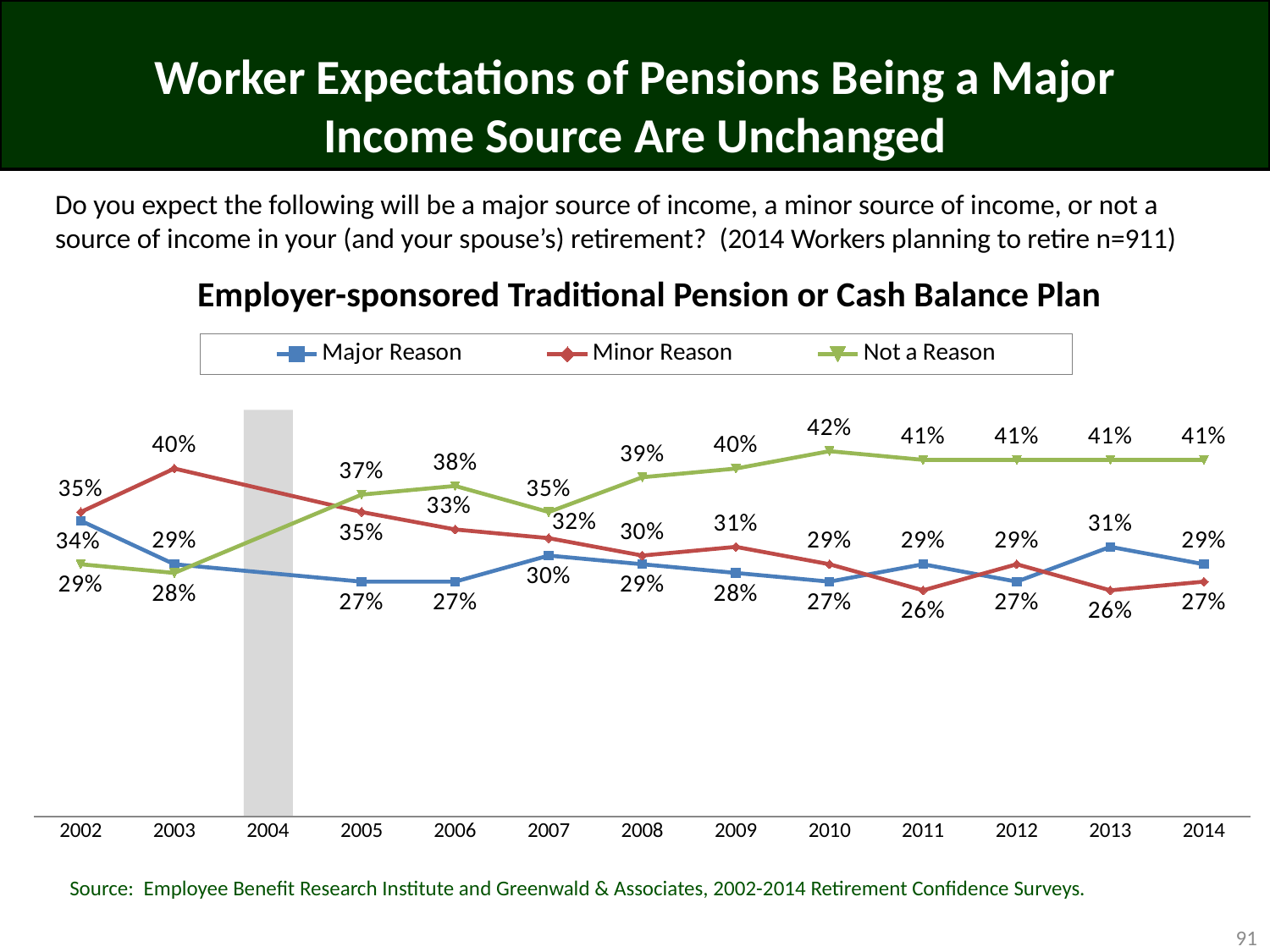
How many series does the legend list? 3 What kind of chart is shown on the slide? Line chart What is the difference between Not a Reason and Major Reason in 2014? 12 percentage points What is the value for Major Reason in 2014? 29% Does the Not a Reason series rise or fall from 2002 to 2010? Rise In 2002, which is larger: Major Reason or Not a Reason? Major Reason What is the value for Not a Reason in 2010? 42% How many years are labeled on the x axis? 13 What is the title of the chart? Employer-sponsored Traditional Pension or Cash Balance Plan What is the lowest value shown for the Minor Reason series? 26% In which year does the Not a Reason series reach its highest value? 2010 What is the value for Minor Reason in 2003? 40%